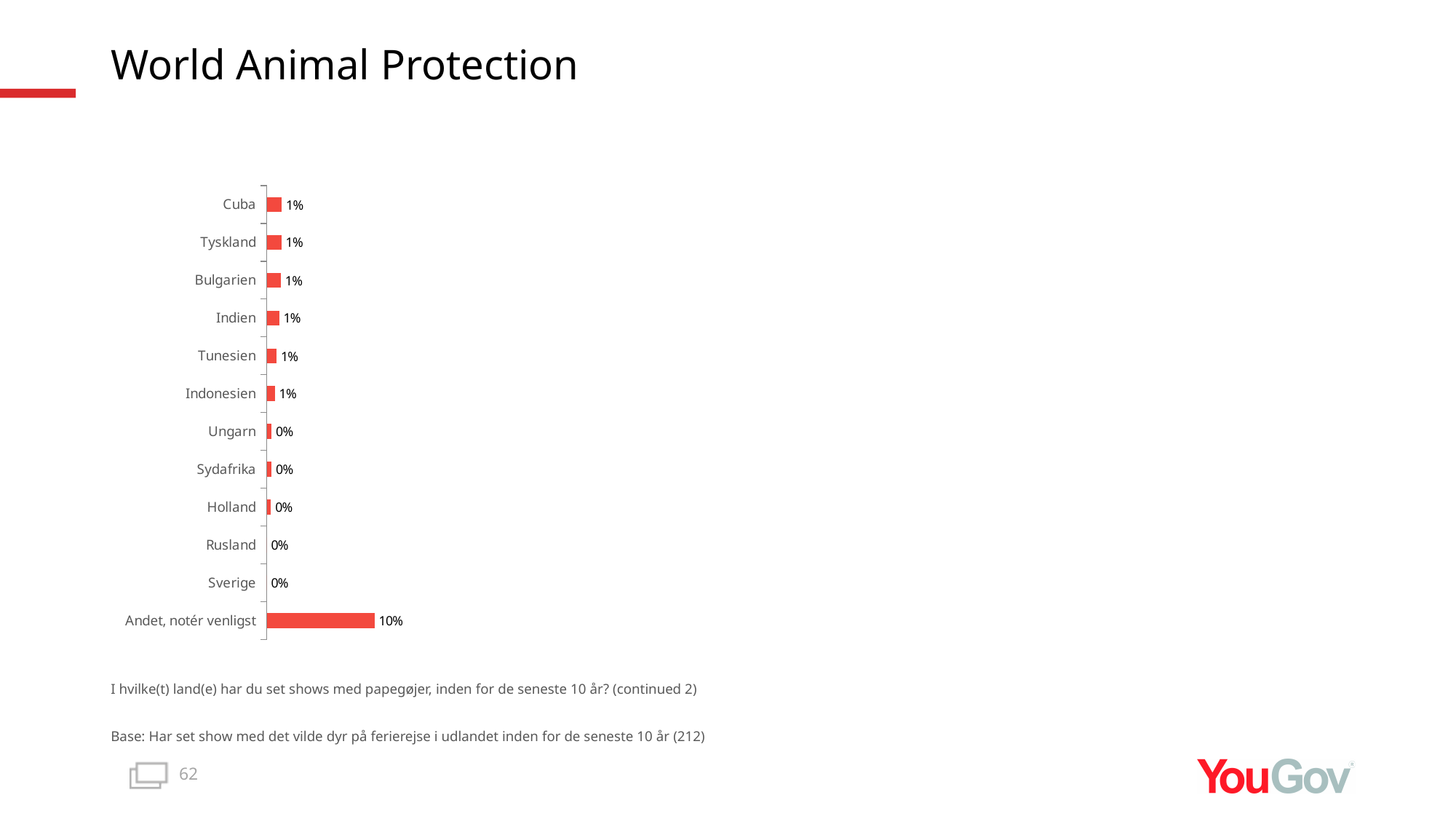
What is the value for Sverige? 0% What is the difference between the values for Andet, notér venligst and Tyskland? 9% What is the title of the slide? World Animal Protection How many categories are shown on the chart? 12 Which category has the highest value? Andet, notér venligst Which is larger, the value for Indien or the value for Andet, notér venligst? Andet, notér venligst What kind of chart is shown on the slide? Bar chart What is the value for Ungarn? 0% How many categories have a value of 1%? 6 What is the value for Andet, notér venligst? 10% What colour are the bars on the chart? Red What is the value for Cuba? 1%